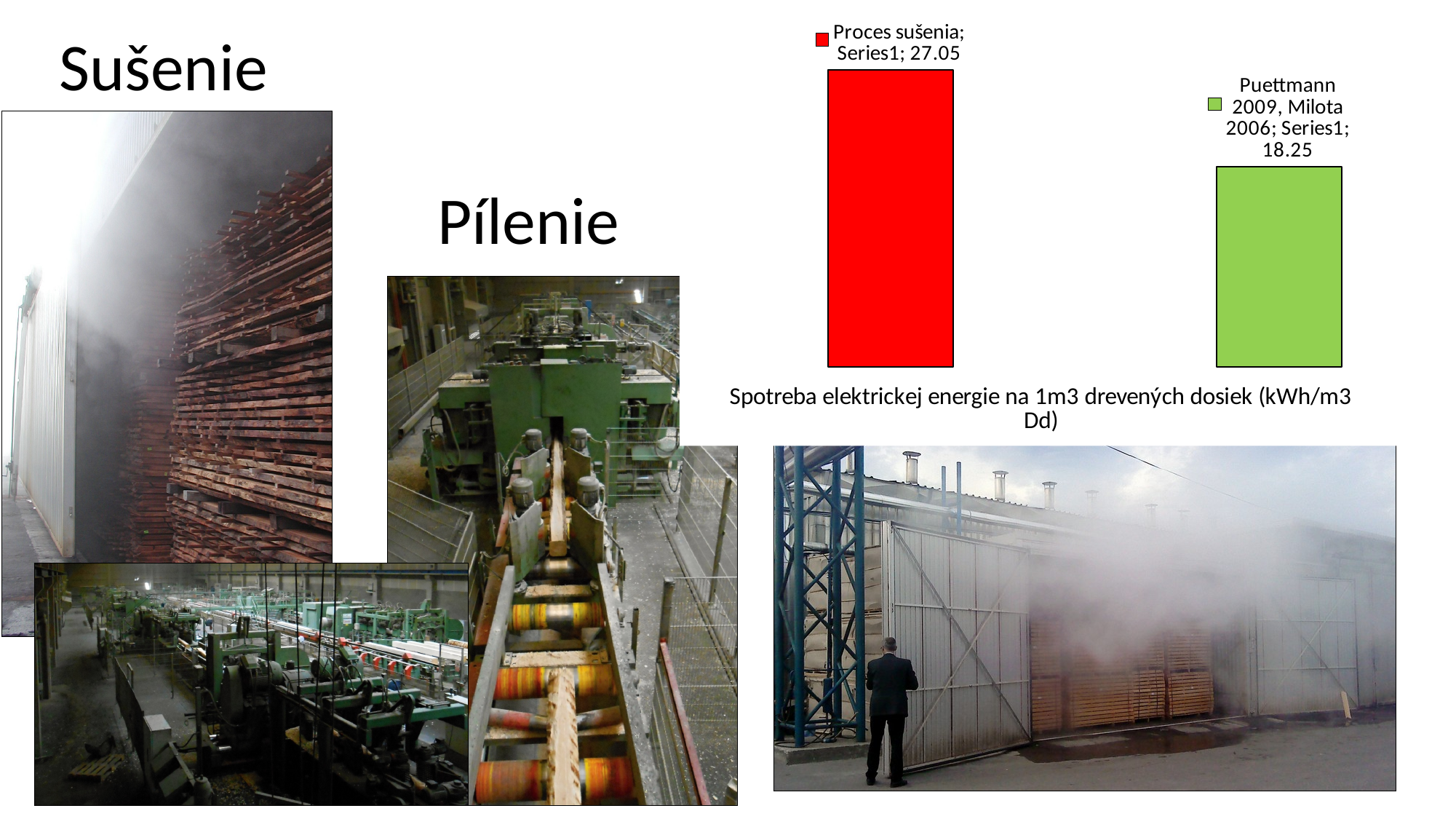
How many bars are plotted in the chart? 2 Which category has the highest value in the chart? Proces sušenia What is the value for Proces sušenia in the chart? 27.05 What kind of chart is shown on the slide? Bar chart What is the difference between the values for Proces sušenia and Puettmann 2009, Milota 2006? 8.8 Which is larger: the value for Proces sušenia or the value for Puettmann 2009, Milota 2006? Proces sušenia What is the title of the chart? Spotreba elektrickej energie na 1m3 drevených dosiek (kWh/m3 Dd) Which category has the lowest value in the chart? Puettmann 2009, Milota 2006 What colour is the bar for Proces sušenia? Red What is the value for Puettmann 2009, Milota 2006 in the chart? 18.25